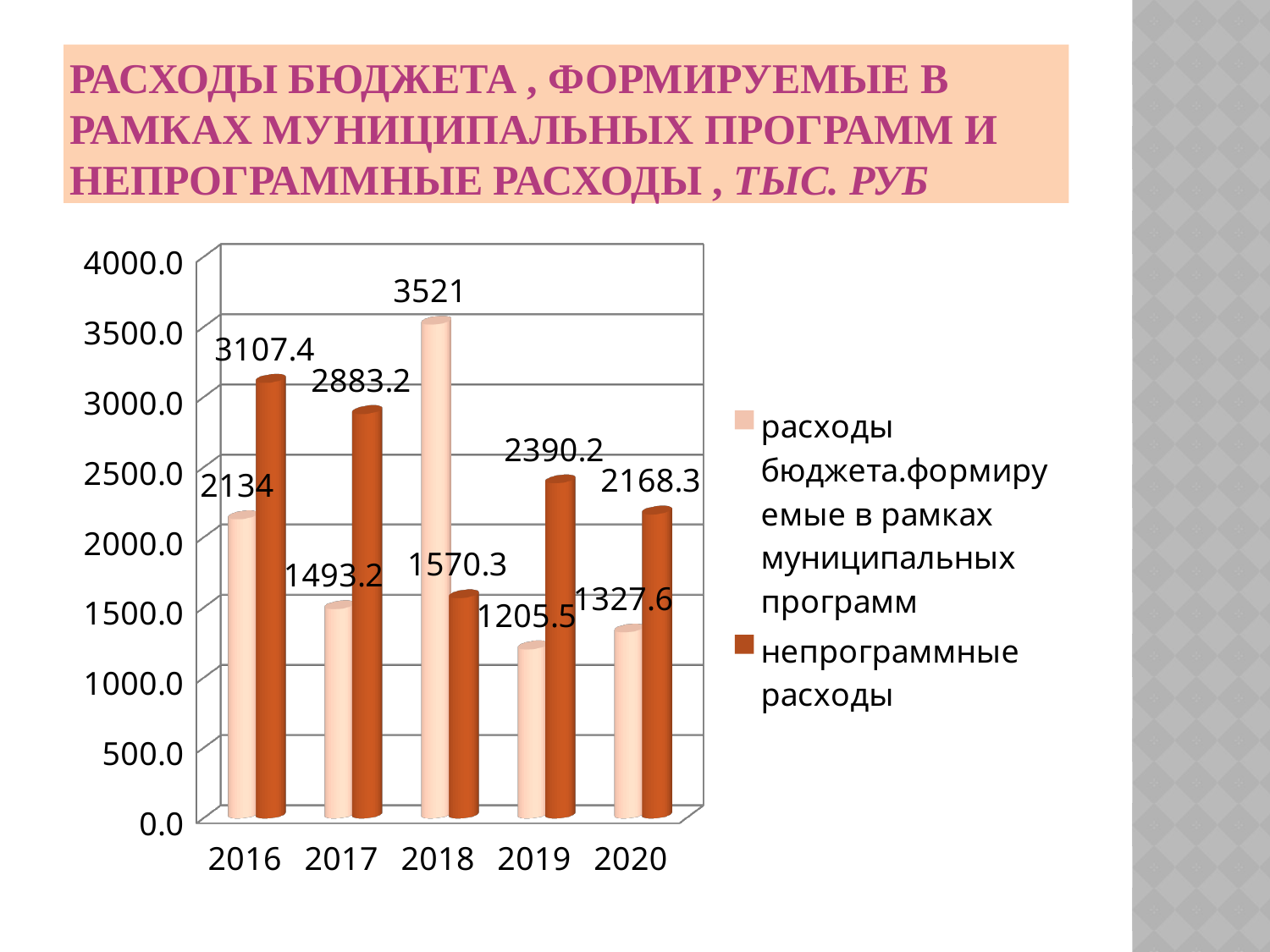
How many years are shown on the x axis? 5 What unit is given in the chart title? тыс. руб How many series does the legend list? 2 What is the difference between непрограммные расходы and расходы бюджета, формируемые в рамках муниципальных программ in 2017? 1390 What kind of chart is shown on the slide? bar chart What is the value of расходы бюджета, формируемые в рамках муниципальных программ for 2018? 3521 What is the value of непрограммные расходы for 2016? 3107.4 Which is larger in 2018: расходы бюджета, формируемые в рамках муниципальных программ or непрограммные расходы? расходы бюджета, формируемые в рамках муниципальных программ In which year is the value of непрограммные расходы the highest? 2016 In which year is the value of расходы бюджета, формируемые в рамках муниципальных программ the lowest? 2019 What is the value of непрограммные расходы for 2020? 2168.3 What is the total of расходы бюджета, формируемые в рамках муниципальных программ and непрограммные расходы in 2019? 3595.7